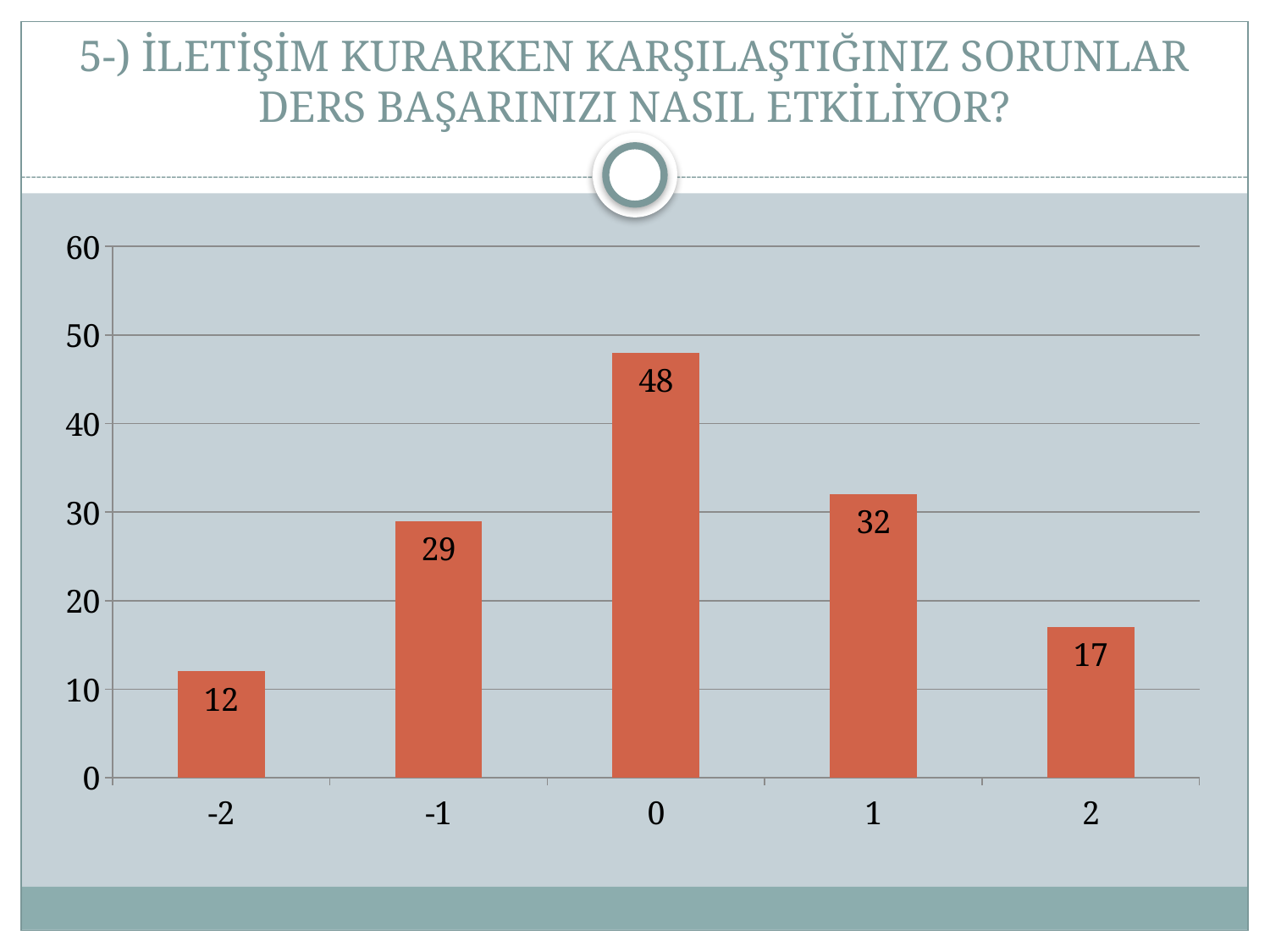
Is the value for category 1 greater or less than 30? greater Which is larger, the value for -1 or the value for 1? 1 What is the value for category 2? 17 What is the value for category -2? 12 What kind of chart is shown on the slide? bar chart How many categories are shown on the x axis? 5 Which category has the highest value? 0 What is the difference between the values for -1 and 2? 12 Which category has the lowest value? -2 What is the difference between the values for 0 and 1? 16 What is the highest value shown on the y axis? 60 What is the value for category 0? 48